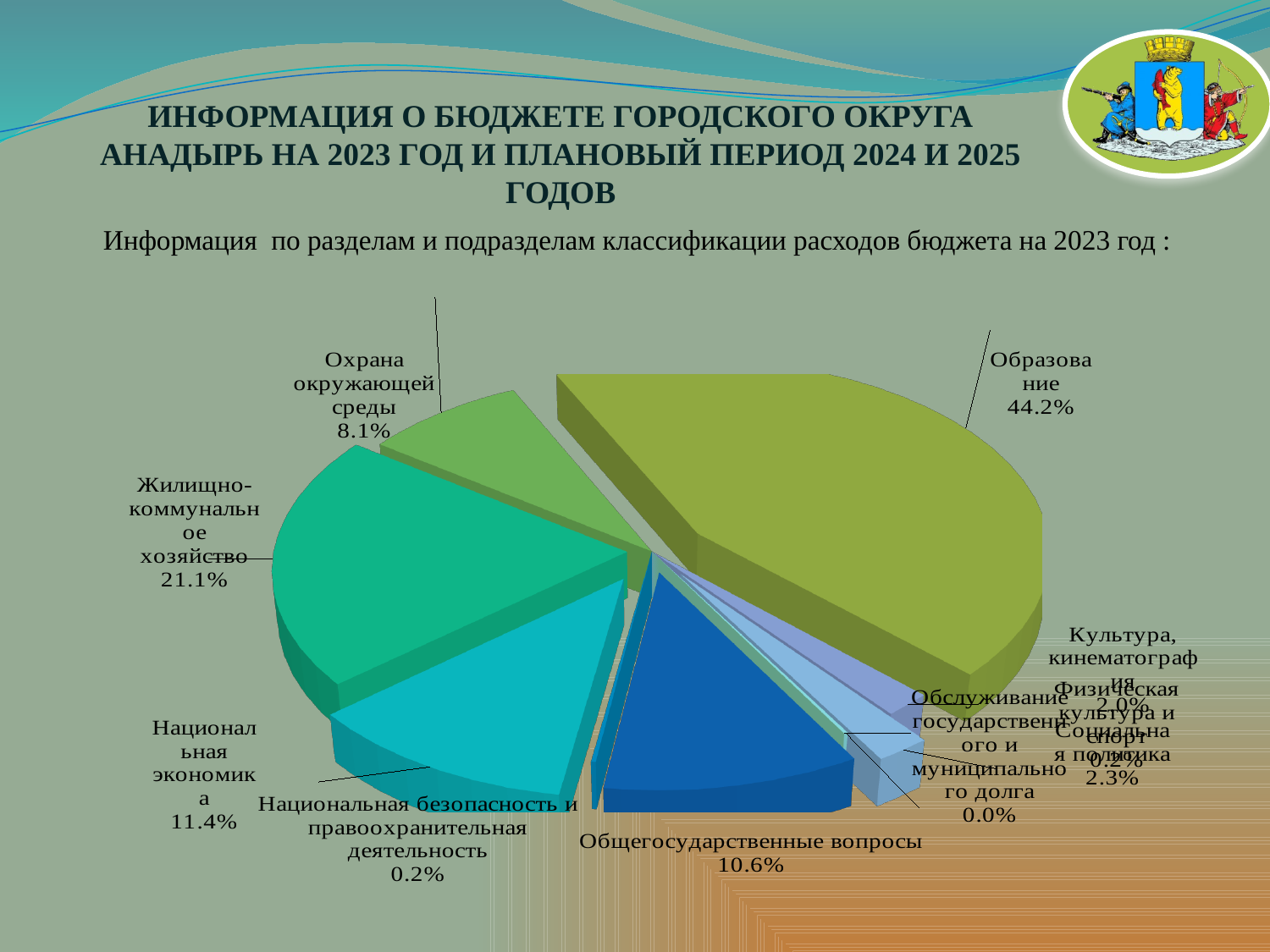
Which section has the smallest share in the pie chart? Обслуживание государственного и муниципального долга What percentage is shown for Общегосударственные вопросы in the pie chart? 10.6% By how many percentage points does Жилищно-коммунальное хозяйство exceed Охрана окружающей среды? 13.0 percentage points What percentage is shown for Обслуживание государственного и муниципального долга in the pie chart? 0.0% What percentage is shown for Национальная экономика in the pie chart? 11.4% By how many percentage points does the share of Образование exceed the share of Жилищно-коммунальное хозяйство? 23.1 percentage points Which has the larger share: Национальная экономика or Общегосударственные вопросы? Национальная экономика What share of the 2023 budget expenditures goes to Образование (education) according to the pie chart? 44.2% What percentage is shown for Охрана окружающей среды in the pie chart? 8.1% What percentage is shown for Жилищно-коммунальное хозяйство in the pie chart? 21.1% What type of chart is used on the slide to show the budget expenditure breakdown? Pie chart Which section has the largest share of the 2023 budget expenditures in the pie chart? Образование